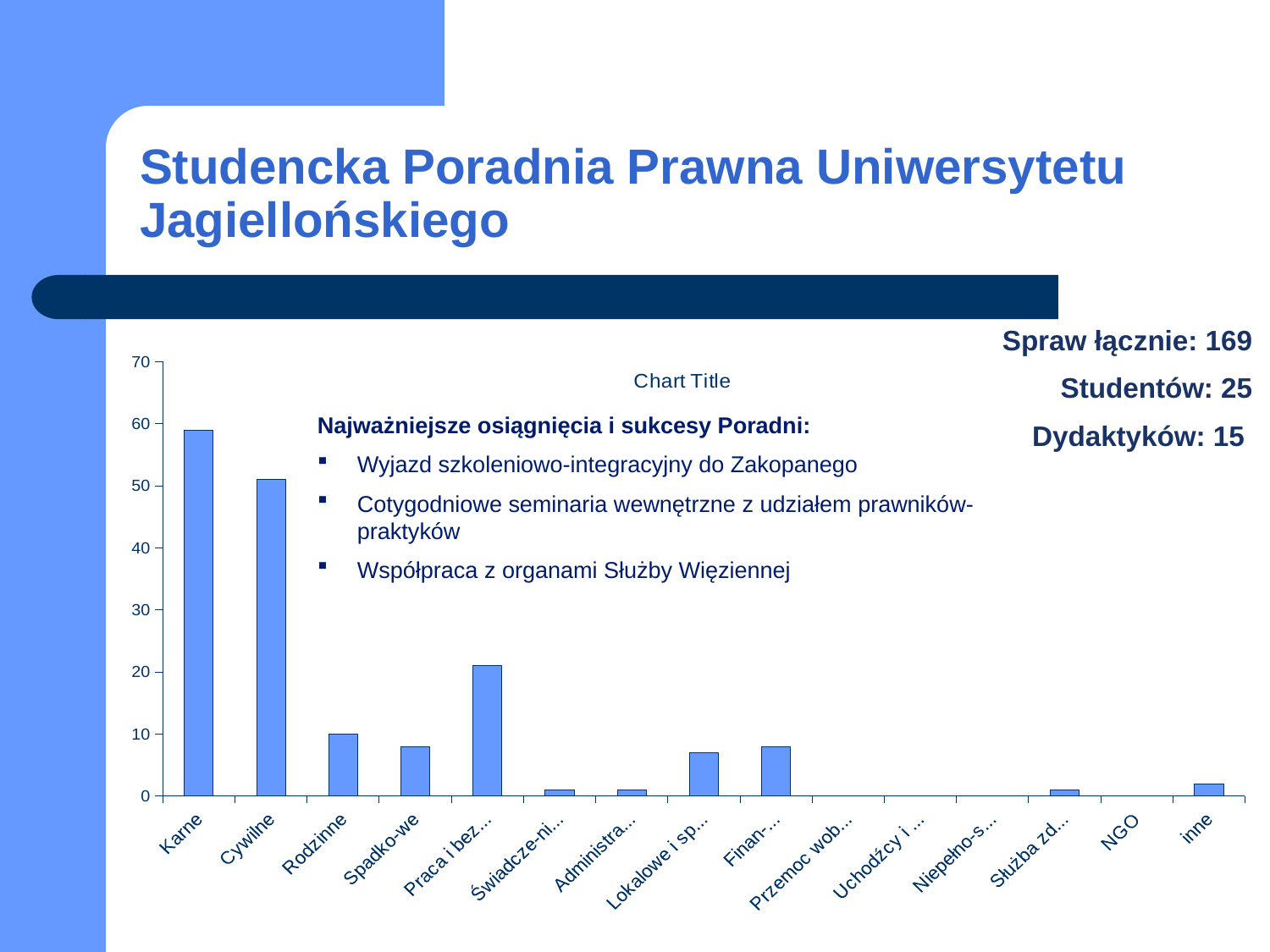
Which category has the highest value in the chart? Karne Which is larger, the value for Cywilne or the value for Praca i bez...? Cywilne What is the title shown on the chart? Chart Title Is the value for Spadko-we greater or less than 10? less Is the value for Praca i bez... greater or less than 30? less Is the value for Karne greater or less than 50? greater What kind of chart is shown on the slide? bar chart Which is larger, the value for Karne or the value for Cywilne? Karne How many categories are shown on the x axis of the chart? 15 Which is larger, the value for Praca i bez... or the value for Rodzinne? Praca i bez...